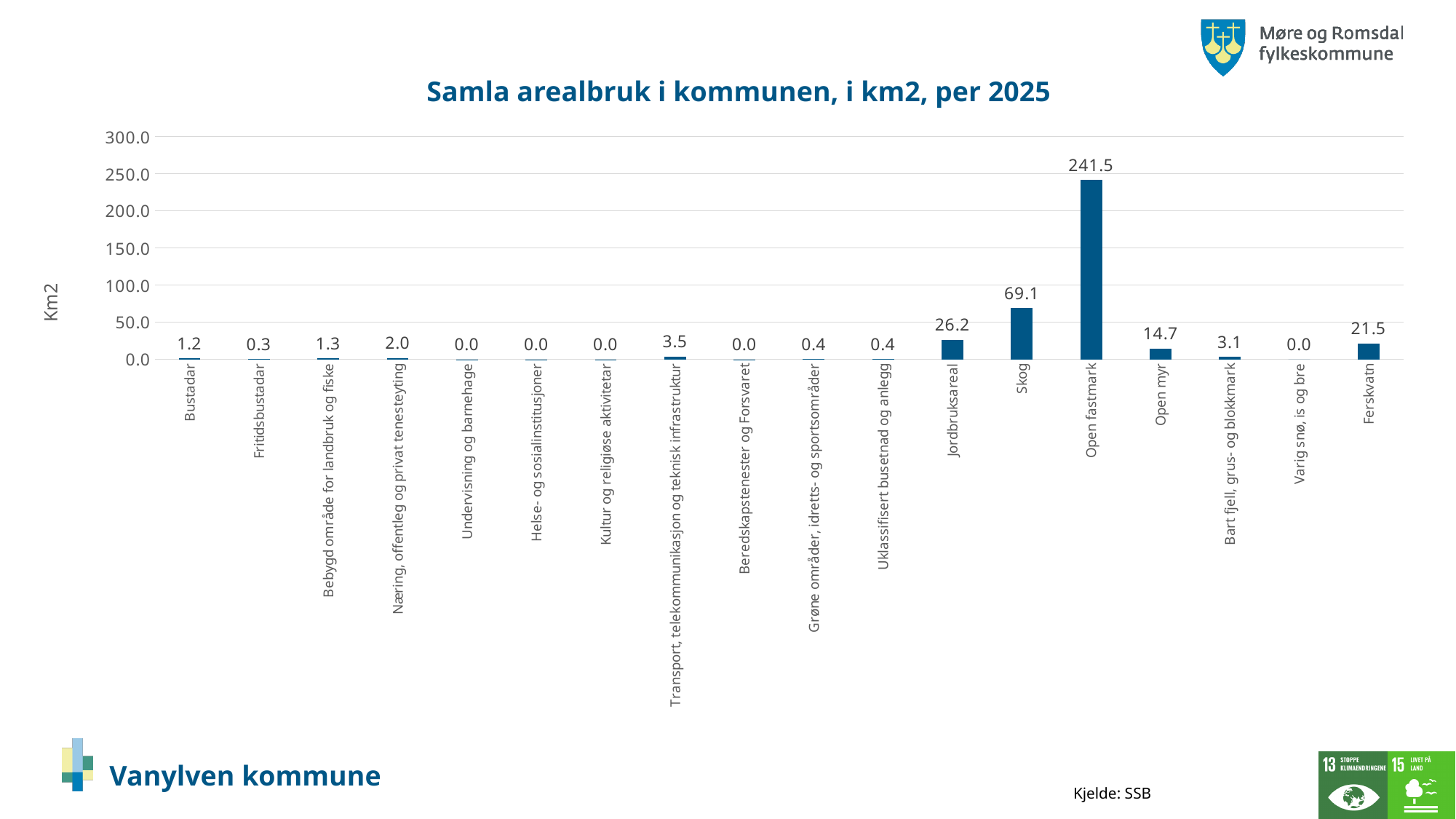
What is the difference between the values for Open fastmark and Skog? 172.4 What is the value for Transport, telekommunikasjon og teknisk infrastruktur? 3.5 Which is larger, the value for Open myr or the value for Ferskvatn? Ferskvatn How many categories are shown on the x axis? 18 What kind of chart is shown? bar chart Is the value for Skog greater or less than 50.0? greater What is the value for Open fastmark? 241.5 What is the value for Ferskvatn? 21.5 Which category has the highest value? Open fastmark What is the value for Jordbruksareal? 26.2 What is the title of the chart? Samla arealbruk i kommunen, i km2, per 2025 What is the value for Skog? 69.1